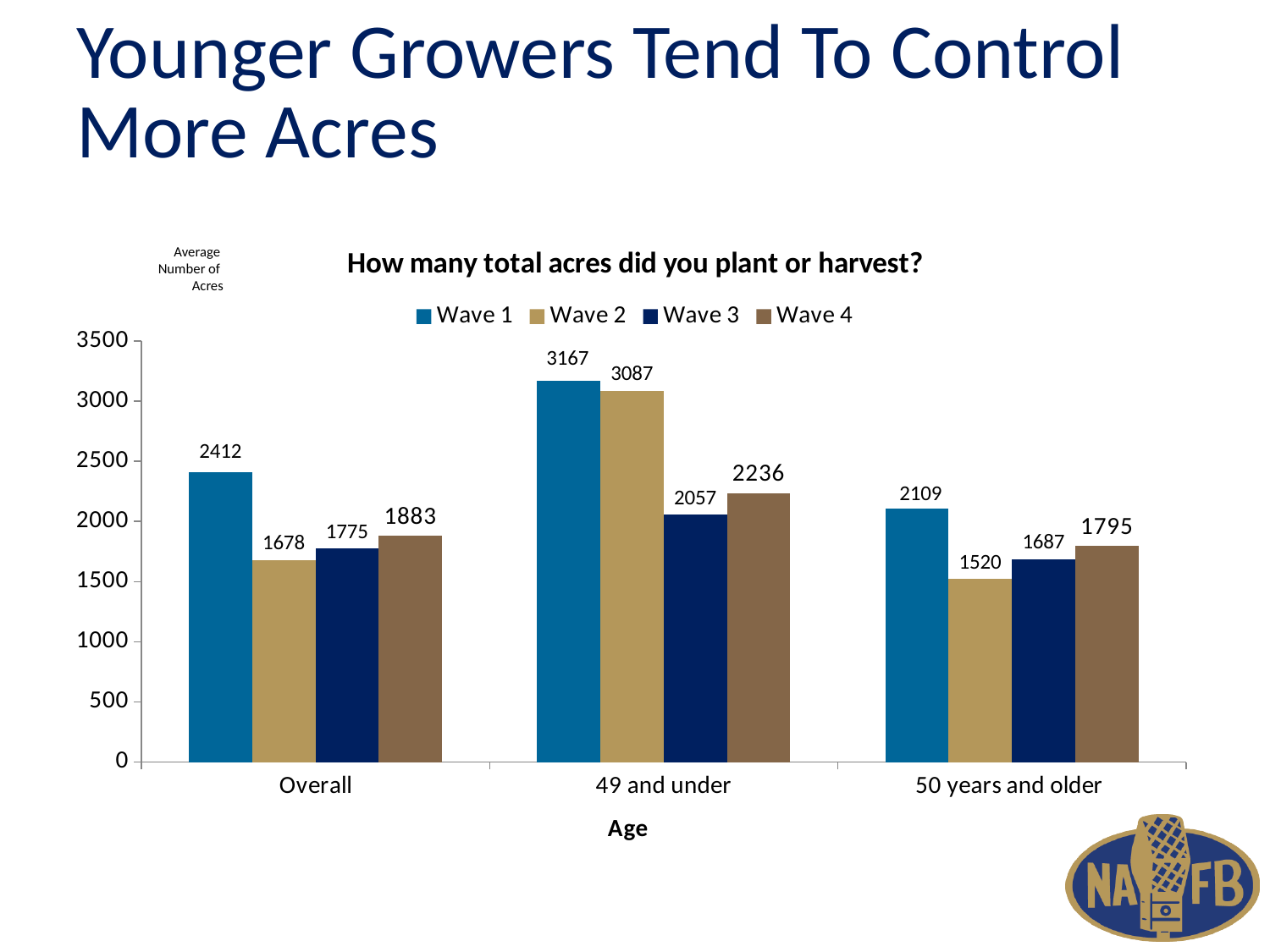
Which wave has the lowest value in the Overall category? Wave 2 What is the Wave 2 value for the 50 years and older group? 1520 What kind of chart is shown on the slide? bar chart How many series does the legend list? 4 Is the Wave 1 value for 50 years and older greater or less than 2000? greater What is the difference between the Wave 4 values for 49 and under and 50 years and older? 441 Which is larger: the Wave 3 value for Overall or the Wave 3 value for 50 years and older? Overall How many age categories are shown on the x axis? 3 Which age category has the highest Wave 3 value? 49 and under What is the difference between the Wave 1 and Wave 2 values for the 49 and under group? 80 What is the Wave 1 value for the 49 and under group? 3167 What is the Wave 4 value for the Overall category? 1883